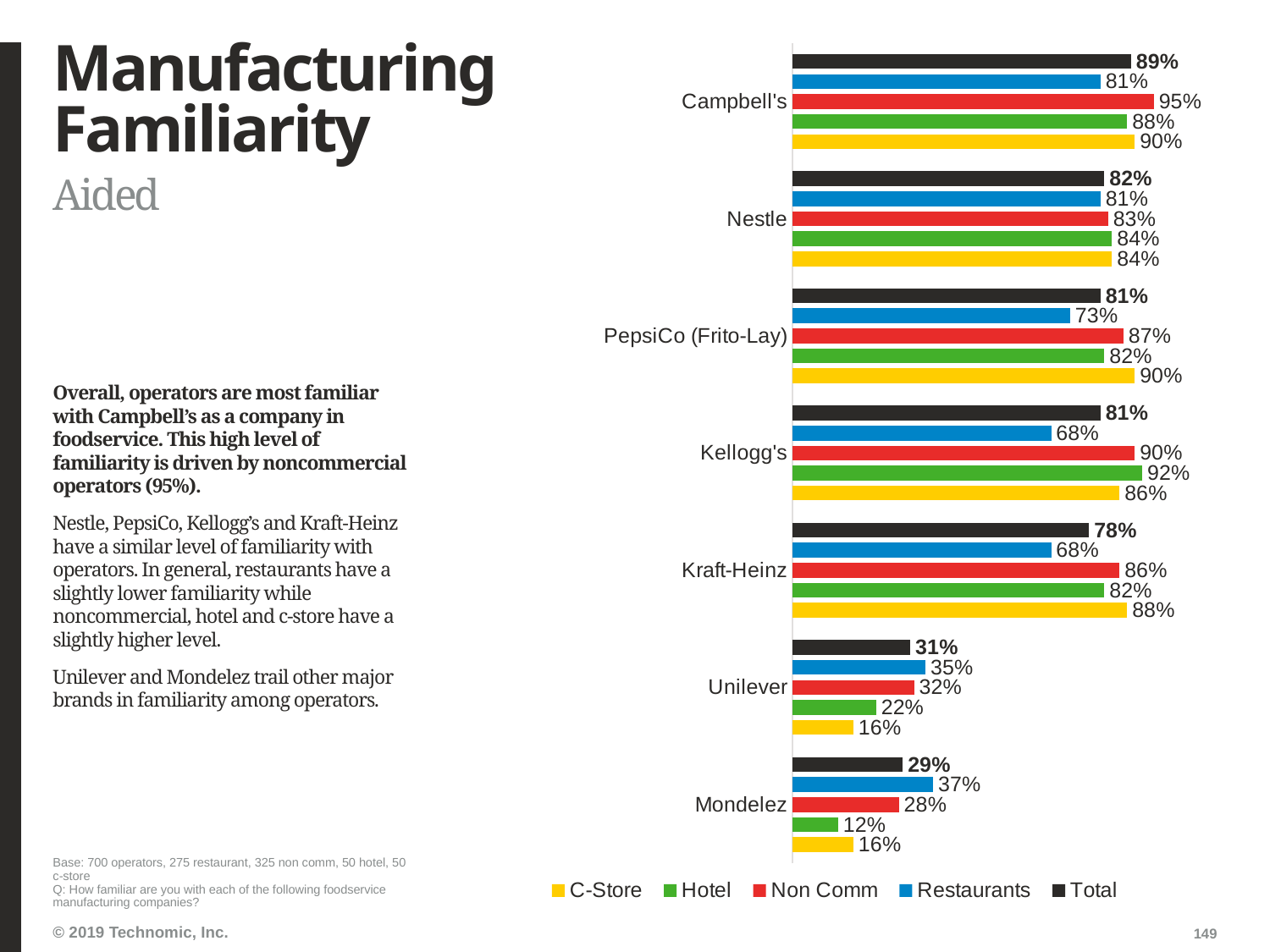
What is the Non Comm value for Kellogg's? 90% What is the difference between the Non Comm and Restaurants values for Campbell's? 14 percentage points What is the Hotel value for Mondelez? 12% How many series does the legend list? 5 How many companies are shown on the chart? 7 Which company has the highest Total familiarity? Campbell's What is the Total familiarity value for Campbell's? 89% What kind of chart is shown on the slide? Bar chart Which colour represents the Non Comm series in the legend? Red Which is larger for Unilever, the Restaurants value or the C-Store value? Restaurants Which company has the lowest Total familiarity? Mondelez What is the Restaurants value for PepsiCo (Frito-Lay)? 73%